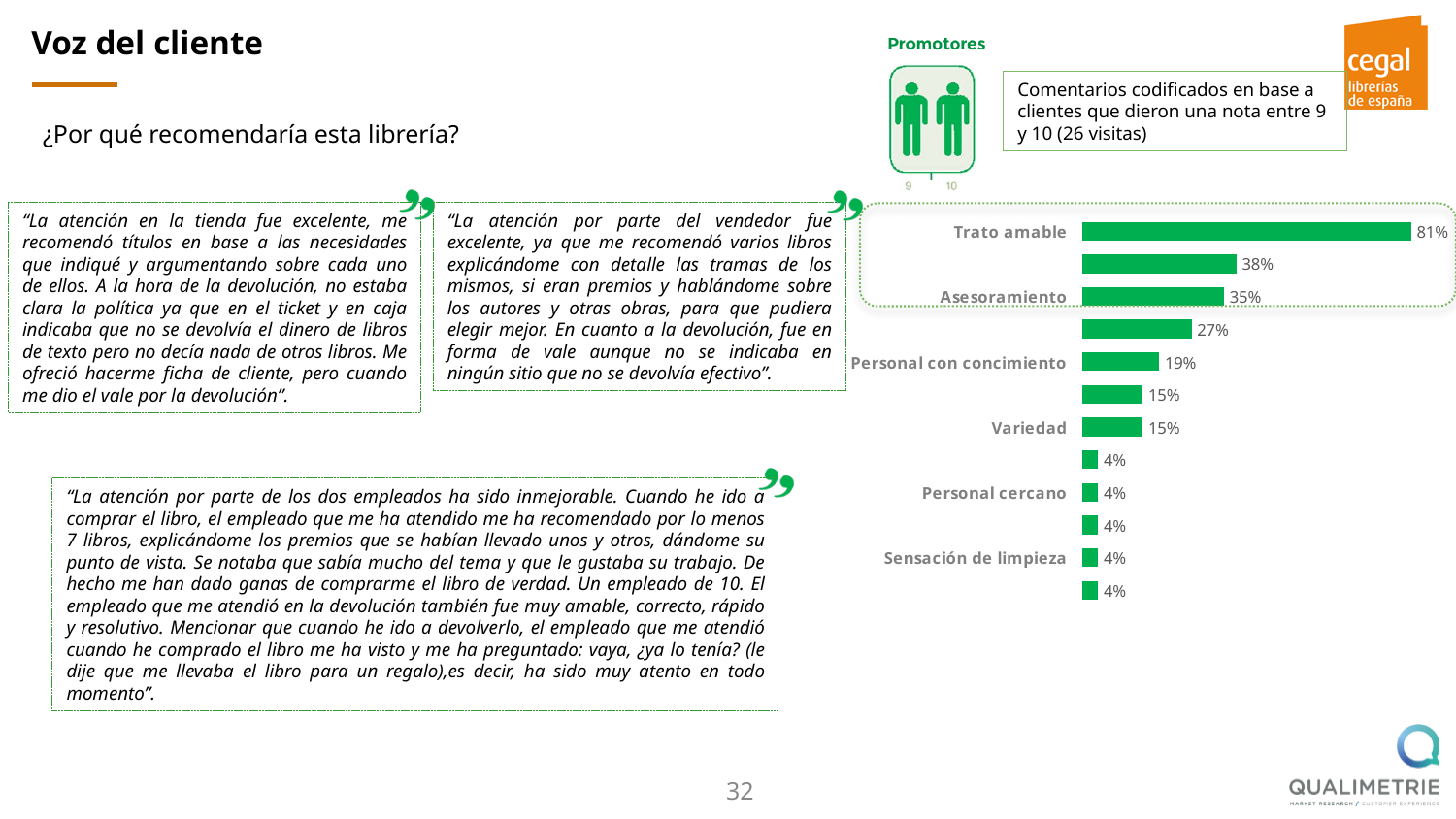
How many bars are plotted in the chart? 12 What kind of chart is shown on the slide? bar chart What is the value for Variedad? 15% What is the difference between the values for Trato amable and Asesoramiento? 46 percentage points What is the value for Asesoramiento? 35% What colour are the bars in the chart? green What is the value for Personal con concimiento? 19% What is the value for Trato amable? 81% What is the value for Personal cercano? 4% Which category has the highest value? Trato amable Which is larger, the value for Asesoramiento or the value for Variedad? Asesoramiento What is the value for Sensación de limpieza? 4%